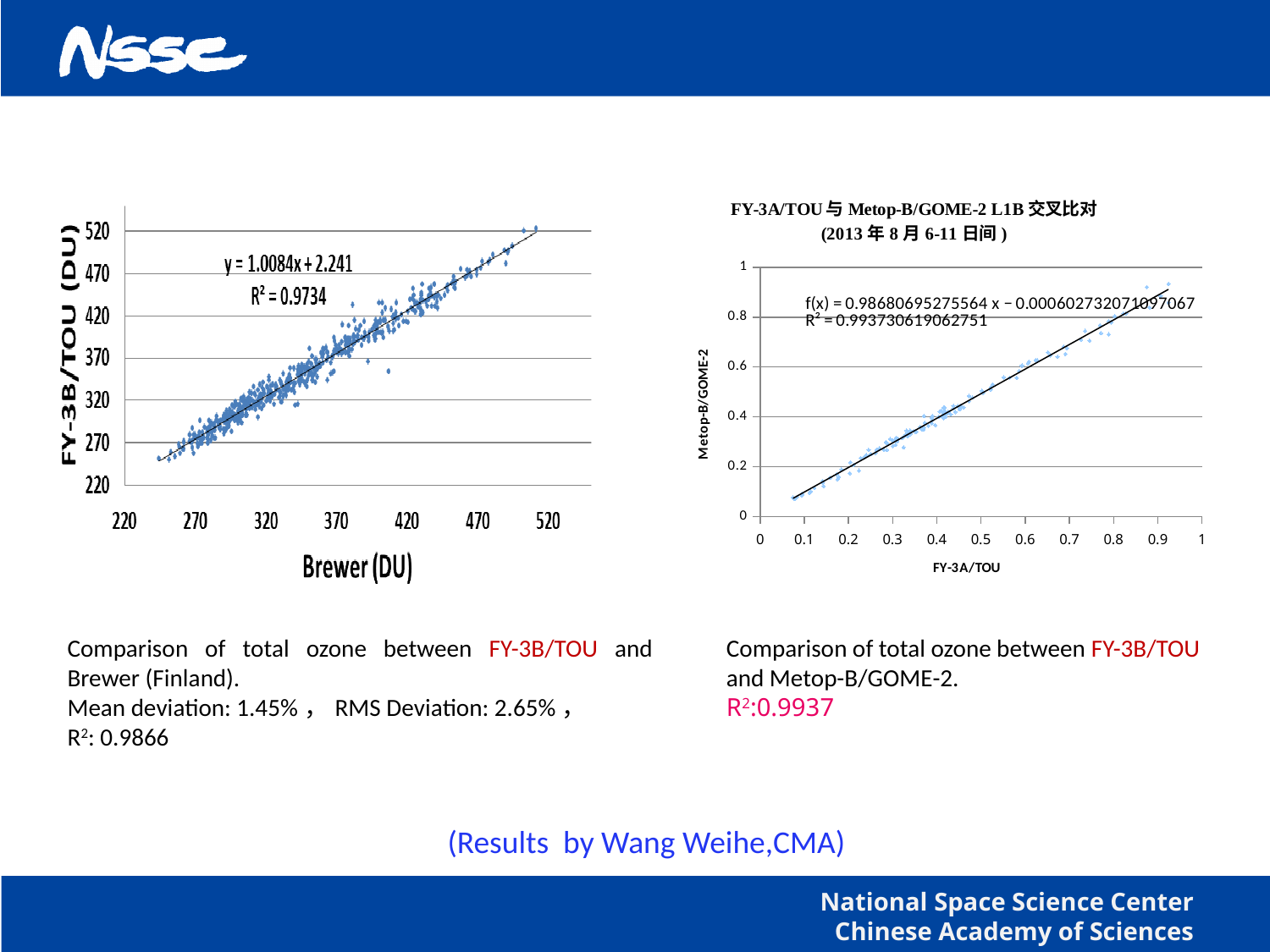
In the right chart, what is the label of the x axis? FY-3A/TOU In the left chart, what is the label of the x axis? Brewer (DU) In the right chart, what is the label of the y axis? Metop-B/GOME-2 In the right chart, do the Metop-B/GOME-2 values rise or fall as the FY-3A/TOU values increase? rise What kind of chart is the right chart titled FY-3A/TOU 与 Metop-B/GOME-2 L1B 交叉比对? scatter chart In the right chart, what is the maximum value shown on the x axis? 1 In the left chart, do the FY-3B/TOU values rise or fall as the Brewer (DU) values increase? rise In the right chart, what R² value is printed on the plot? R² = 0.993730619062751 In the left chart, what is the fitted regression equation shown? y = 1.0084x + 2.241 In the left chart, what R² value is printed on the plot? R² = 0.9734 What kind of chart is the left chart comparing FY-3B/TOU with Brewer (DU)? scatter chart